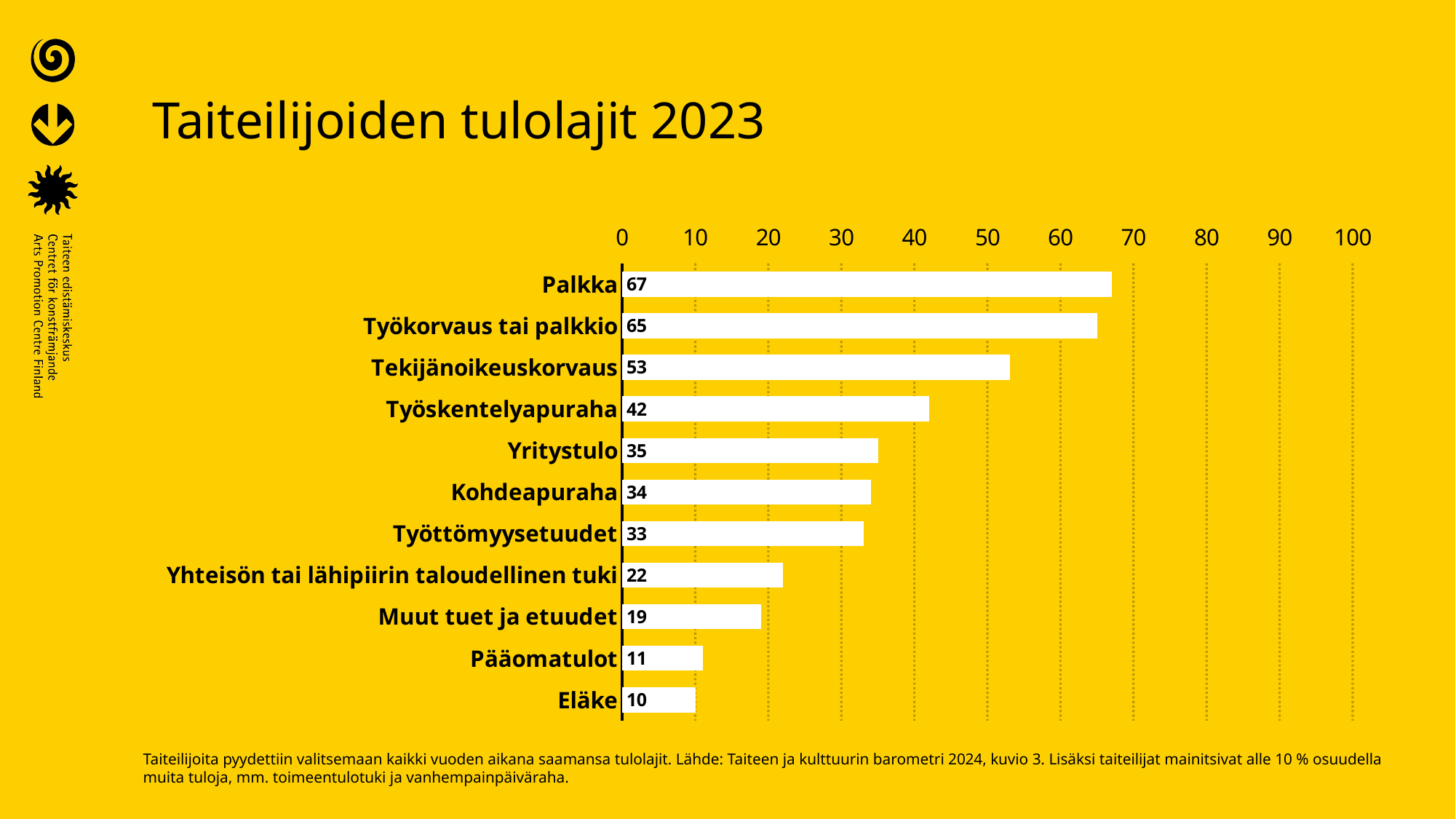
What is the value for Työskentelyapuraha? 42 Which is larger, the value for Työttömyysetuudet or the value for Yhteisön tai lähipiirin taloudellinen tuki? Työttömyysetuudet What is the title of the chart? Taiteilijoiden tulolajit 2023 Is the value for Työkorvaus tai palkkio greater or less than 60? greater Which category has the lowest value? Eläke What kind of chart is shown on the slide? bar chart What is the difference between the values for Yritystulo and Muut tuet ja etuudet? 16 How many categories are shown in the chart? 11 What is the value for Pääomatulot? 11 What is the value for Palkka? 67 Which category has the highest value? Palkka What is the difference between the values for Palkka and Tekijänoikeuskorvaus? 14